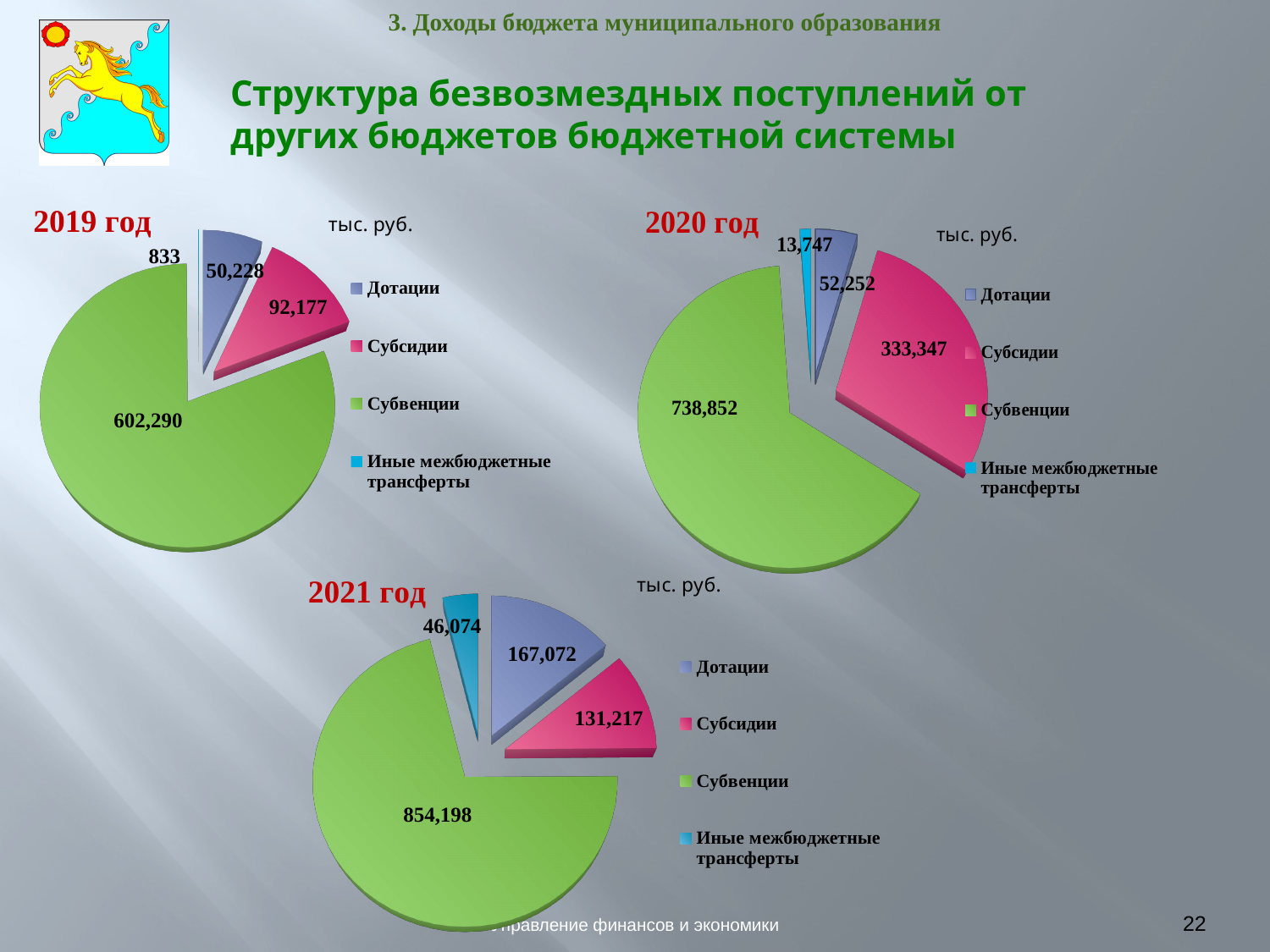
In the 2019 год pie chart, which category has the smallest value? Иные межбюджетные трансферты In the 2021 год pie chart, which is larger, Дотации or Субсидии? Дотации What type of chart is used for 2019 год? Pie chart What unit is shown next to each pie chart? тыс. руб. In the 2020 год pie chart, what is the value for Субсидии? 333,347 In the 2020 год pie chart, what is the difference between Субвенции and Субсидии? 405,505 In the 2019 год pie chart, what is the value for Субвенции? 602,290 In the 2021 год pie chart, what is the difference between Дотации and Субсидии? 35,855 In the 2021 год pie chart, what is the value for Иные межбюджетные трансферты? 46,074 In the 2021 год pie chart, which category has the largest value? Субвенции How many slices does the 2020 год pie chart have? 4 What is the total of all slices in the 2019 год pie chart? 745,528